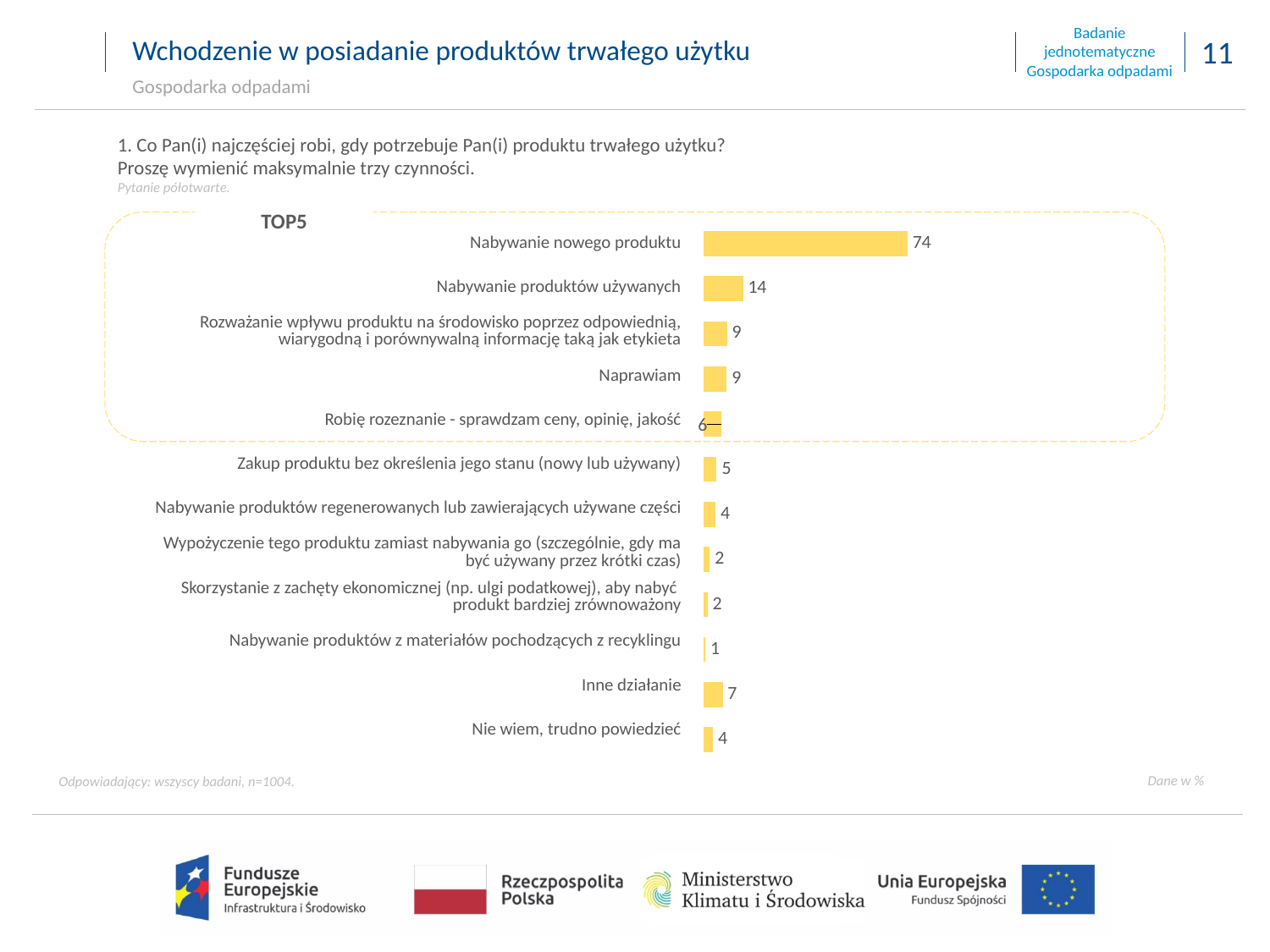
What is the value for "Nabywanie produktów używanych"? 14 Which is larger: the value for "Inne działanie" or the value for "Nie wiem, trudno powiedzieć"? Inne działanie What is the value for "Nabywanie nowego produktu"? 74 What is the difference between the values for "Nabywanie nowego produktu" and "Nabywanie produktów używanych"? 60 What is the value for "Nabywanie produktów z materiałów pochodzących z recyklingu"? 1 What kind of chart is shown on the slide? Bar chart What label is shown on the dashed box enclosing the first five bars? TOP5 What is the value for "Naprawiam"? 9 Which category has the highest value? Nabywanie nowego produktu What is the value for "Inne działanie"? 7 How many categories are shown in the chart? 12 Which category has the lowest value? Nabywanie produktów z materiałów pochodzących z recyklingu